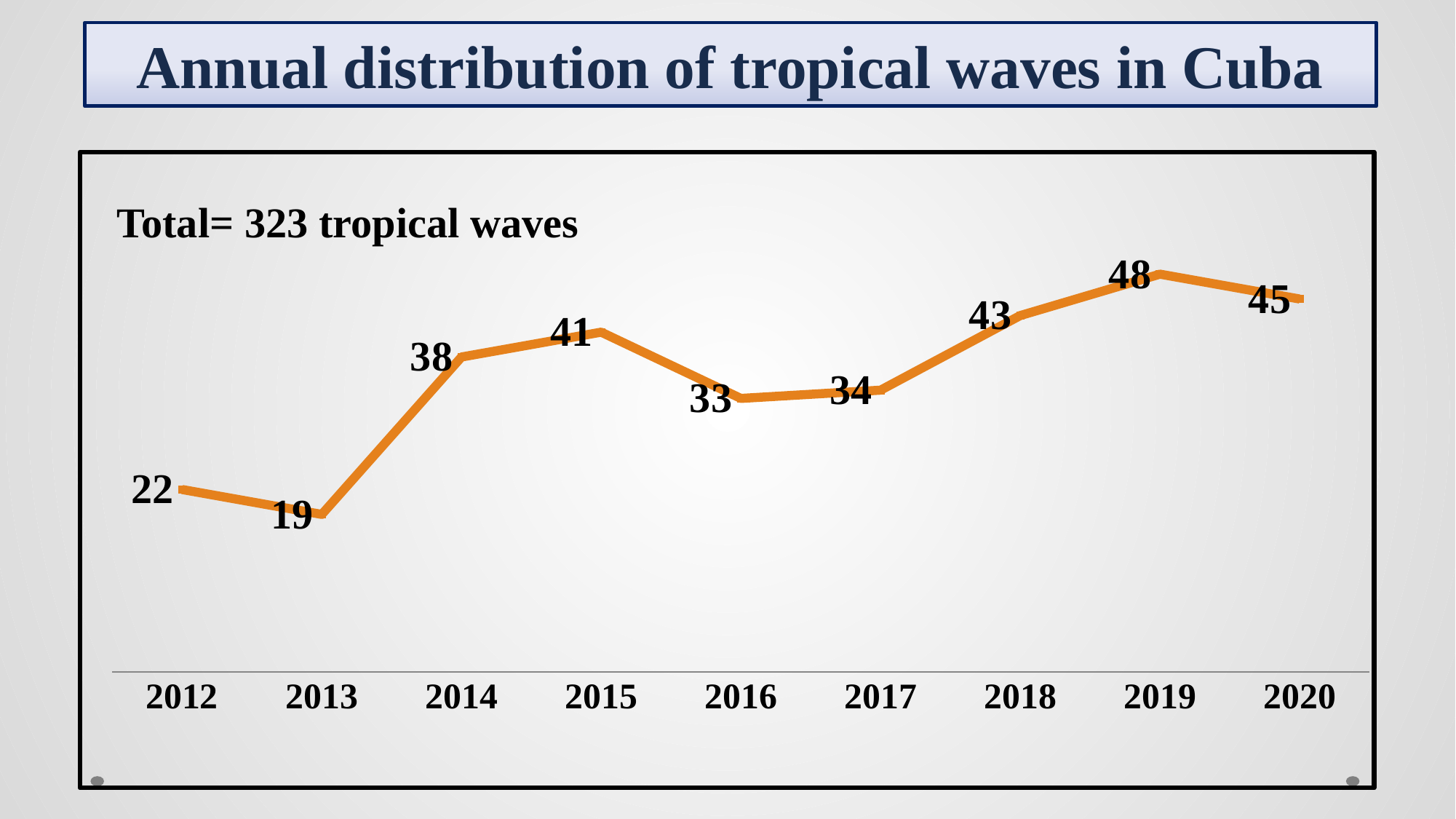
Which year has the highest number of tropical waves? 2019 Does the number of tropical waves rise or fall from 2019 to 2020? fall What is the difference between the values for 2019 and 2013? 29 What is the title of the slide? Annual distribution of tropical waves in Cuba How many tropical waves were recorded in 2014? 38 How many years are plotted on the x axis? 9 By how much did the number of tropical waves change from 2013 to 2014? 19 Which year has the lowest number of tropical waves? 2013 What total number of tropical waves is stated on the chart? 323 Which year has a larger value, 2015 or 2018? 2018 What is the value for 2017? 34 What type of chart is shown on the slide? line chart